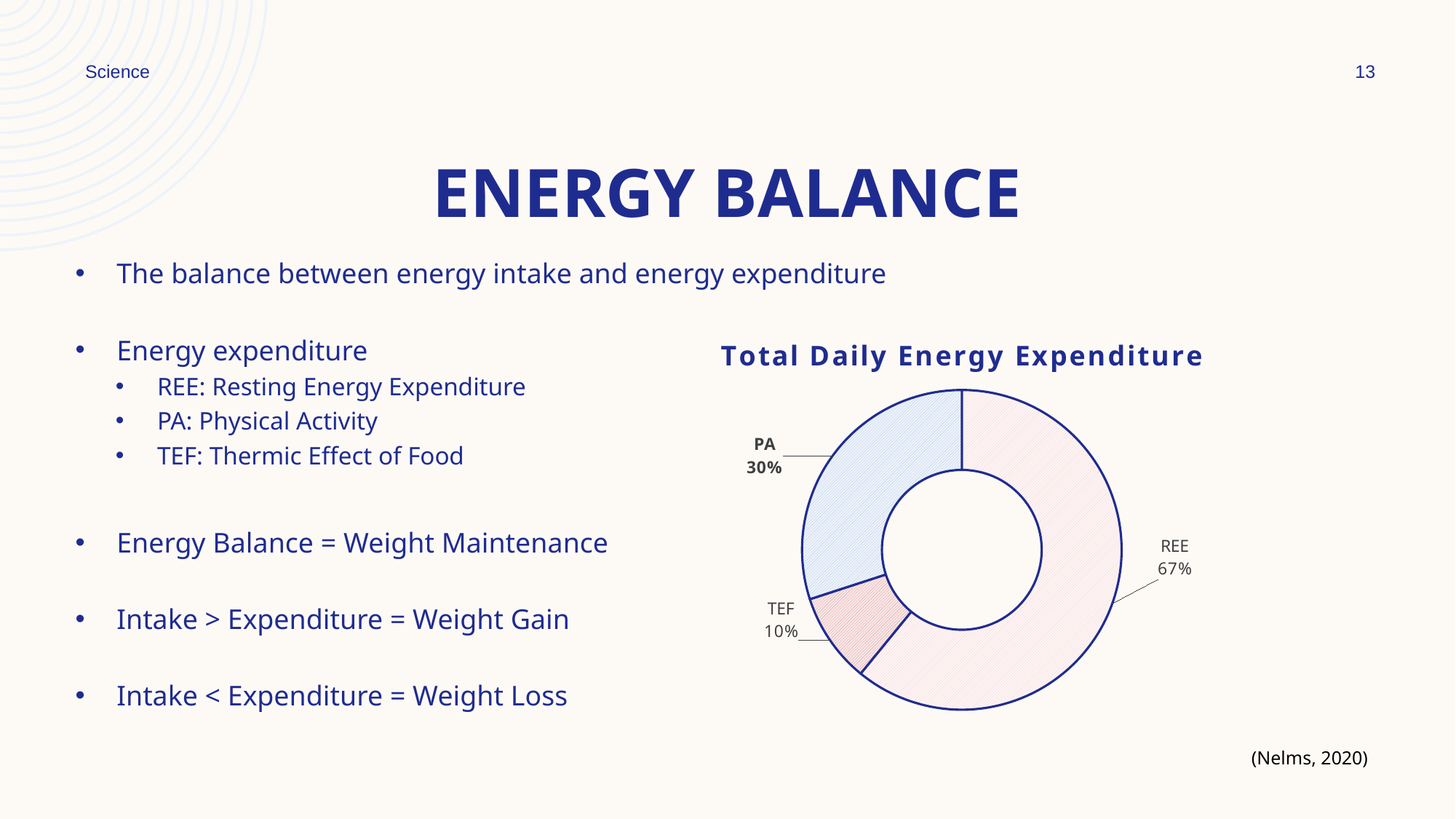
Which component has the largest share of Total Daily Energy Expenditure? REE What kind of chart is used to show Total Daily Energy Expenditure? Doughnut (pie) chart What share of Total Daily Energy Expenditure is REE? 67% Which slice of the chart is shaded blue? PA Which component has the smallest share of Total Daily Energy Expenditure? TEF What share of Total Daily Energy Expenditure is TEF? 10% How many slices does the Total Daily Energy Expenditure chart have? 3 What is the difference in percentage points between the PA and TEF shares? 20 What share of Total Daily Energy Expenditure is PA? 30% What is the difference in percentage points between the REE and PA shares? 37 What is the title of the chart on the slide? Total Daily Energy Expenditure Which is larger, the share for PA or the share for TEF? PA